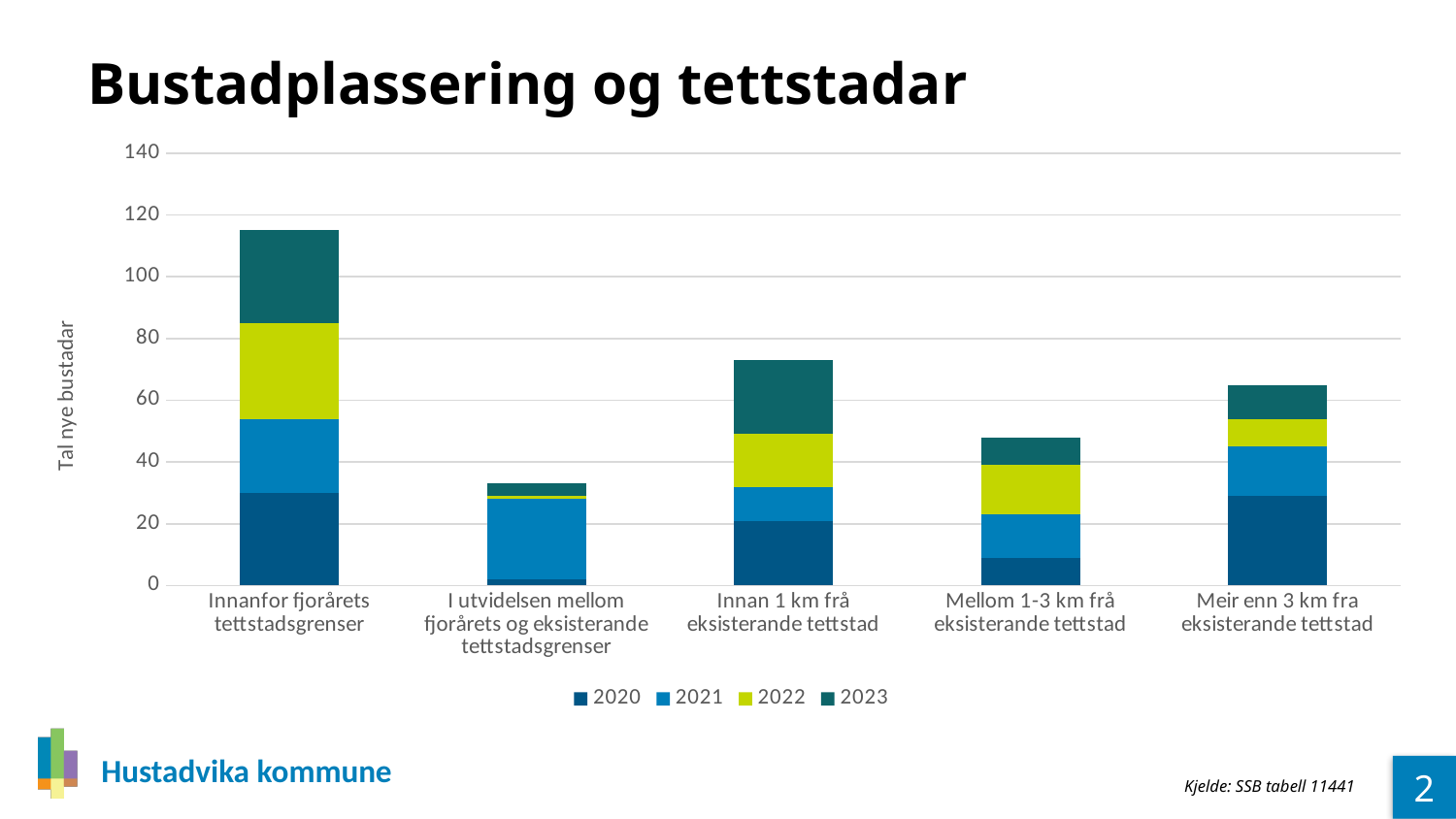
Which has the larger total stacked bar: 'Innan 1 km frå eksisterande tettstad' or 'Meir enn 3 km fra eksisterande tettstad'? Innan 1 km frå eksisterande tettstad Is the total stacked value for 'Mellom 1-3 km frå eksisterande tettstad' greater or less than 60? less How many series does the chart's legend list? 4 What kind of chart is shown on the slide? Stacked bar chart What is the label of the chart's vertical axis? Tal nye bustadar How many categories are shown on the x axis of the chart? 5 Is the total stacked value for 'I utvidelsen mellom fjorårets og eksisterande tettstadsgrenser' greater or less than 40? less Is the total stacked value for 'Innanfor fjorårets tettstadsgrenser' greater or less than 100? greater Which category has the lowest total stacked bar? I utvidelsen mellom fjorårets og eksisterande tettstadsgrenser What is the title of the chart on the slide? Bustadplassering og tettstadar Which category has the highest total stacked bar? Innanfor fjorårets tettstadsgrenser